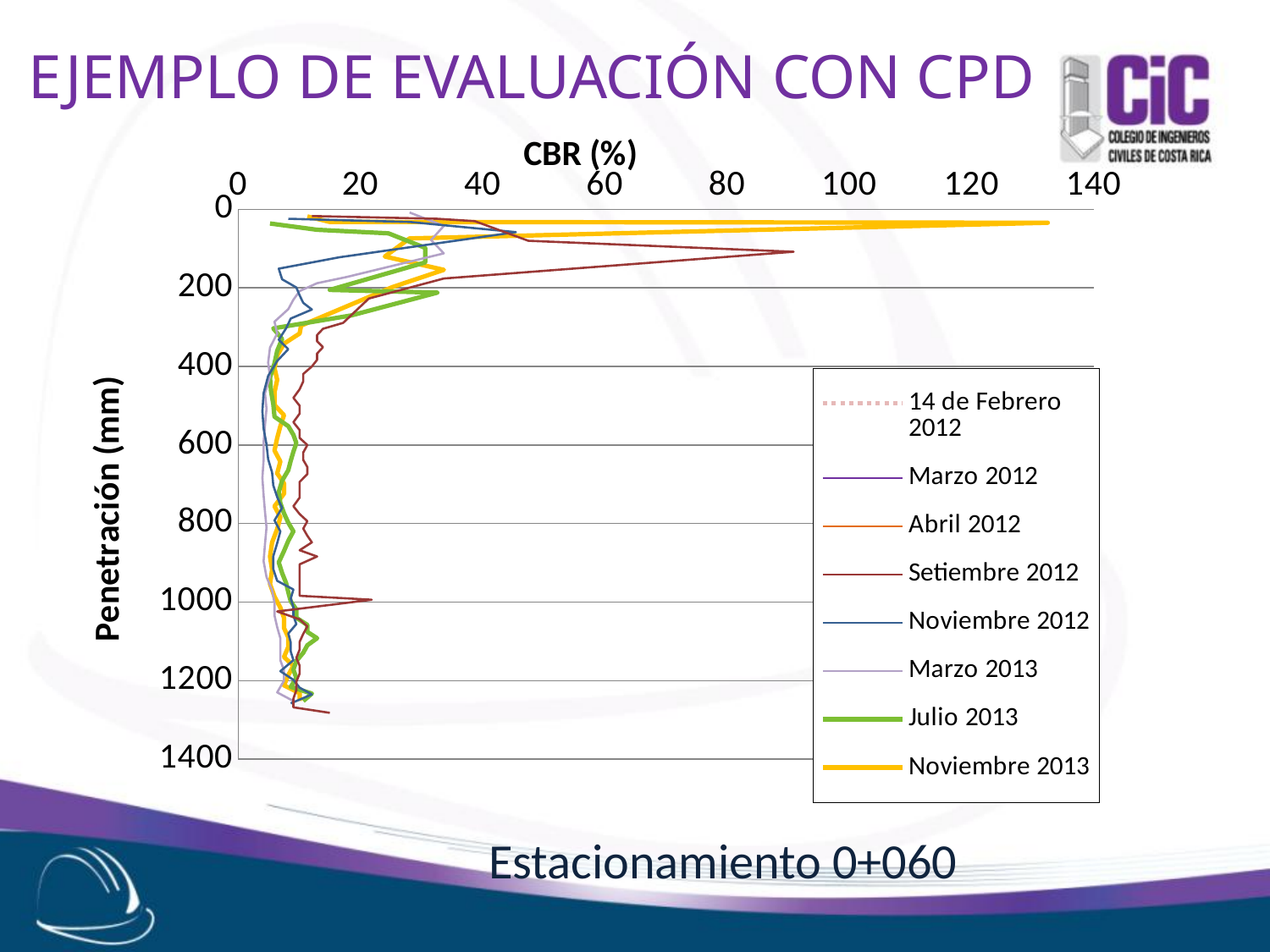
Do the CBR (%) values for Noviembre 2013 rise or fall as penetration increases from 200 mm to 600 mm? fall What is the title of the vertical axis? Penetración (mm) Is the peak CBR (%) value for Noviembre 2013 greater or less than 120? greater Which series has the larger peak CBR (%) value, Noviembre 2013 or Setiembre 2012? Noviembre 2013 Is the peak CBR (%) value for Setiembre 2012 greater or less than 100? less What is the title of the horizontal axis? CBR (%) How many series does the legend list? 8 Which series shows a spike in CBR (%) near 1000 mm penetration? Setiembre 2012 What is the maximum value shown on the CBR (%) axis? 140 Is the peak CBR (%) value for Setiembre 2012 greater or less than 80? greater What kind of chart is shown on the slide? line chart Which series reaches the highest CBR (%) value on the chart? Noviembre 2013